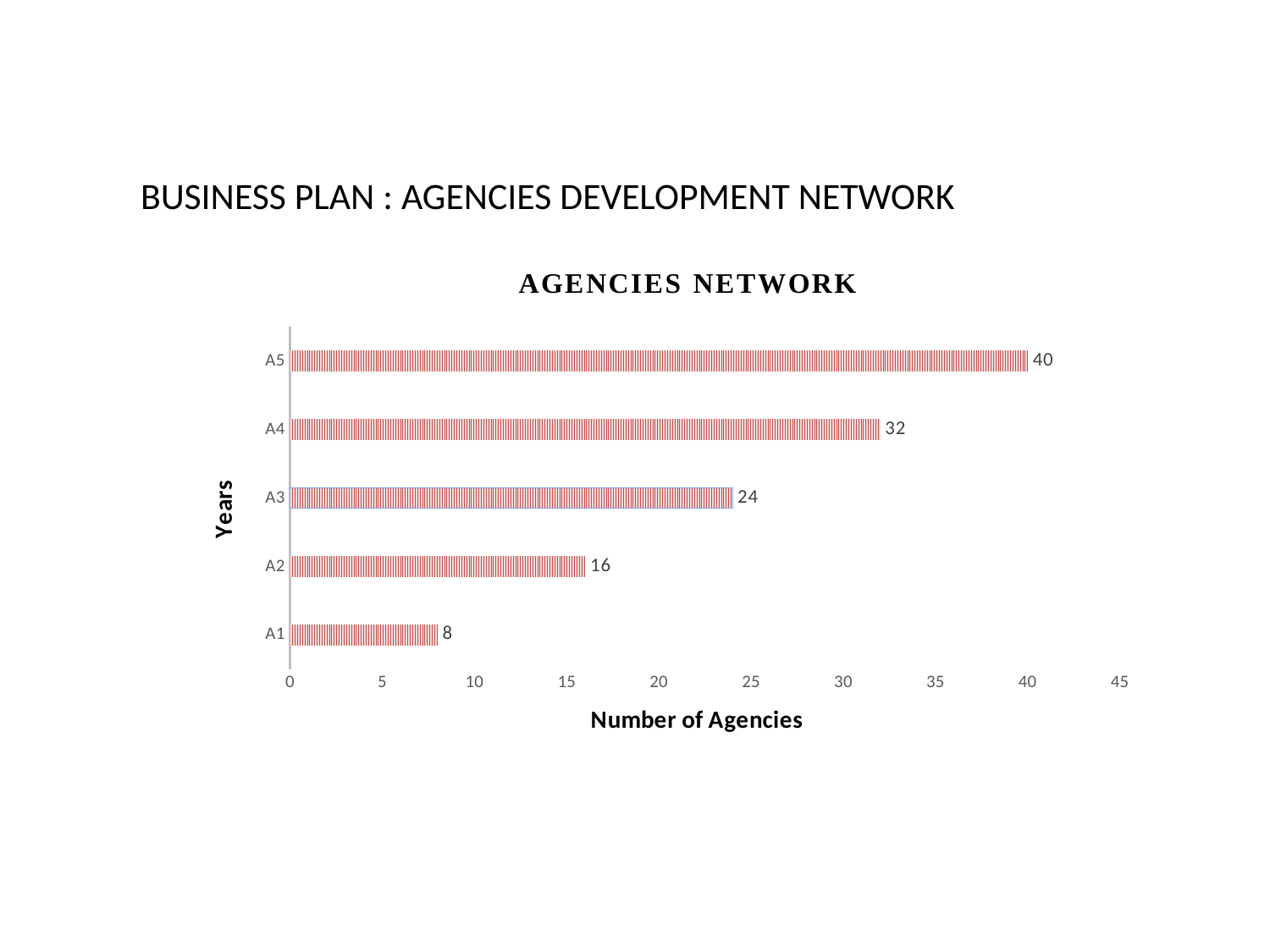
What is the title of the chart? AGENCIES NETWORK What is the number of agencies for A5? 40 What kind of chart is shown on the slide? Bar chart Which year has the highest number of agencies? A5 What is the number of agencies for A1? 8 What is the label of the horizontal axis? Number of Agencies Is the value for A4 greater or less than 30? greater Which has more agencies, A2 or A3? A3 Which year has the lowest number of agencies? A1 How many years (categories) are shown in the chart? 5 What is the number of agencies for A3? 24 What is the difference in number of agencies between A4 and A2? 16